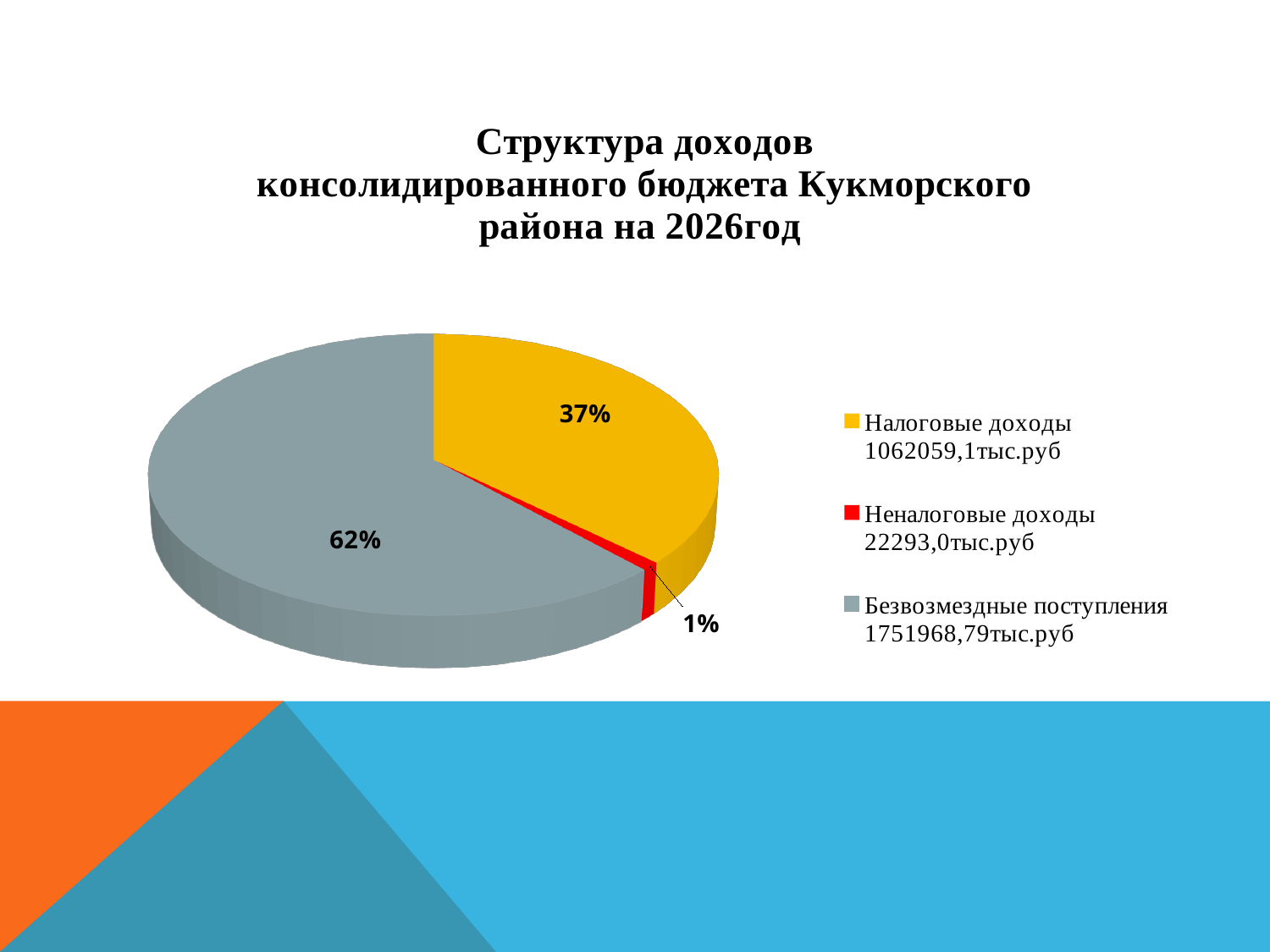
How many slices does the pie chart have? 3 Which colour represents Безвозмездные поступления in the pie chart? grey What amount is given in the legend for Неналоговые доходы? 22293,0тыс.руб What share of the pie does Неналоговые доходы represent? 1% What share of the pie does Безвозмездные поступления represent? 62% How many entries does the legend list? 3 What kind of chart is shown on the slide? pie chart Which category has the smallest share of the pie? Неналоговые доходы Which is larger: the share of Налоговые доходы or the share of Неналоговые доходы? Налоговые доходы What is the difference in percentage points between the shares of Безвозмездные поступления and Налоговые доходы? 25 What share of the pie does Налоговые доходы represent? 37% Which category has the largest share of the pie? Безвозмездные поступления